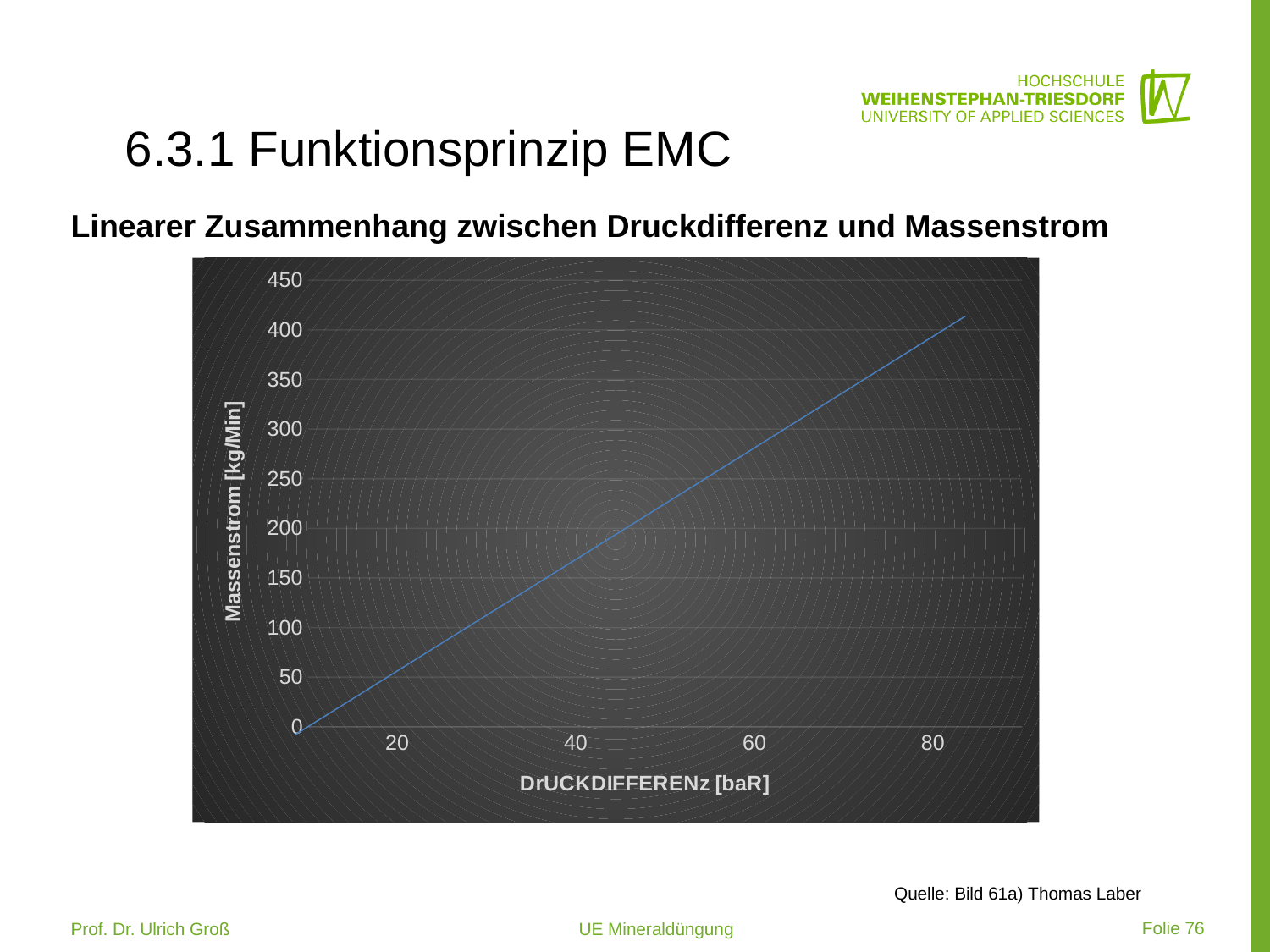
Is the Massenstrom at a Druckdifferenz of 40 bar greater or less than 150 kg/Min? greater What is the label of the y axis of the chart? Massenstrom [kg/Min] Is the Massenstrom at a Druckdifferenz of 80 bar greater or less than 350 kg/Min? greater What is the highest tick value shown on the y axis? 450 What kind of chart is shown on the slide? line chart Is the Massenstrom at a Druckdifferenz of 40 bar greater or less than 200 kg/Min? less Which of the two is larger: the Massenstrom at 40 bar or at 60 bar? 60 bar Does the Massenstrom rise or fall as the Druckdifferenz increases along the x axis? rise